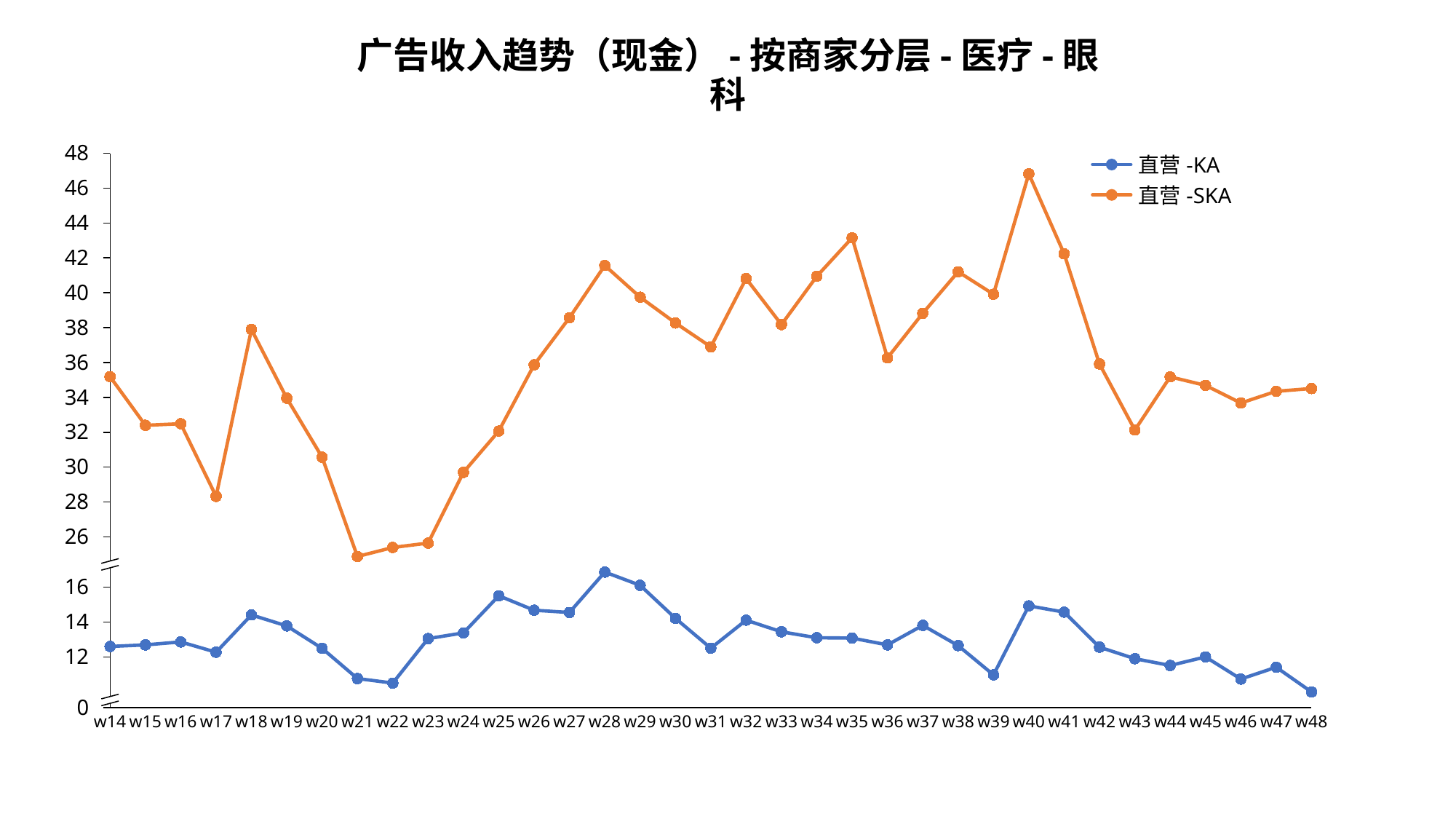
Is the value for 直营-SKA at w40 greater or less than 46? greater Is the value for 直营-SKA at w21 greater or less than 26? less Is the value for 直营-SKA at w17 greater or less than 30? less For 直营-SKA, which is larger: the value at w28 or the value at w35? w35 How many weeks are plotted along the x axis? 35 Does the 直营-SKA series rise or fall from w21 to w28? rise What kind of chart is shown on the slide? line chart In which week does the 直营-KA series reach its lowest value? w48 How many series does the legend list? 2 In which week does the 直营-SKA series reach its highest value? w40 In which week does the 直营-KA series reach its highest value? w28